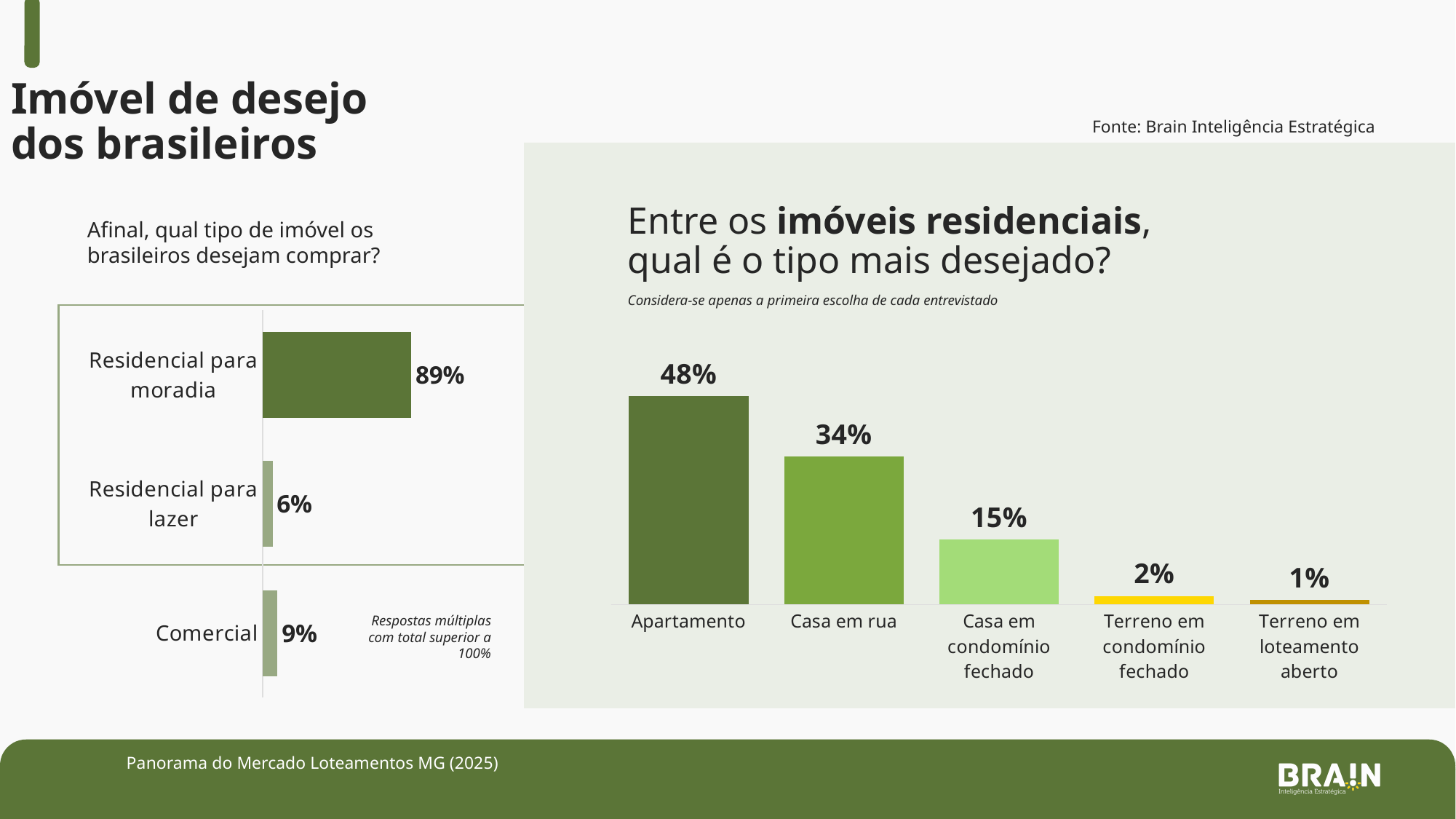
In the left chart ("Afinal, qual tipo de imóvel os brasileiros desejam comprar?"), how many categories are shown? 3 In the left chart ("Afinal, qual tipo de imóvel os brasileiros desejam comprar?"), which category has the lowest value? Residencial para lazer In the right chart ("Entre os imóveis residenciais, qual é o tipo mais desejado?"), which is larger: Casa em rua or Casa em condomínio fechado? Casa em rua In the right chart ("Entre os imóveis residenciais, qual é o tipo mais desejado?"), what is the value for Casa em rua? 34% In the left chart ("Afinal, qual tipo de imóvel os brasileiros desejam comprar?"), what is the difference between Residencial para moradia and Comercial? 80% In the left chart ("Afinal, qual tipo de imóvel os brasileiros desejam comprar?"), what is the value for Comercial? 9% What kind of chart is the right chart ("Entre os imóveis residenciais, qual é o tipo mais desejado?")? Bar chart In the right chart ("Entre os imóveis residenciais, qual é o tipo mais desejado?"), which category has the highest value? Apartamento In the left chart ("Afinal, qual tipo de imóvel os brasileiros desejam comprar?"), what is the value for Residencial para moradia? 89% In the right chart ("Entre os imóveis residenciais, qual é o tipo mais desejado?"), what is the difference between Apartamento and Casa em condomínio fechado? 33% In the right chart ("Entre os imóveis residenciais, qual é o tipo mais desejado?"), what is the value for Terreno em condomínio fechado? 2% In the right chart ("Entre os imóveis residenciais, qual é o tipo mais desejado?"), which category has the lowest value? Terreno em loteamento aberto